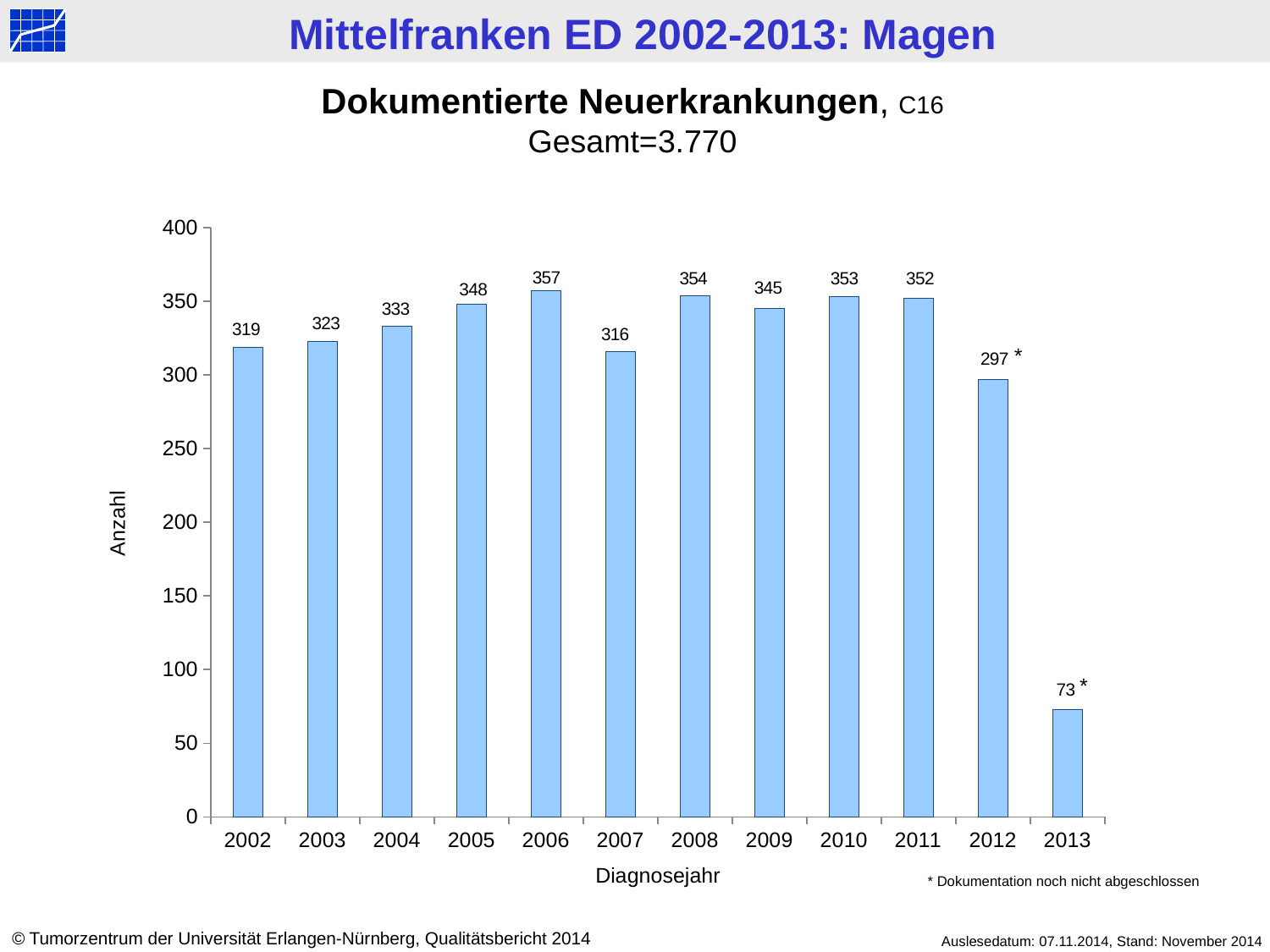
What is the value for 2012? 297 What total (Gesamt) is stated above the chart? 3.770 Is the value for 2013 greater or less than 100? less Which year has the highest value? 2006 Which year has the lowest value? 2013 What is the value for 2006? 357 Do the values rise or fall from 2011 to 2013? fall What is the label of the y axis? Anzahl What kind of chart is this? bar chart How many years are shown on the x axis? 12 What is the difference between the values for 2006 and 2007? 41 Which is larger, the value for 2002 or the value for 2003? 2003